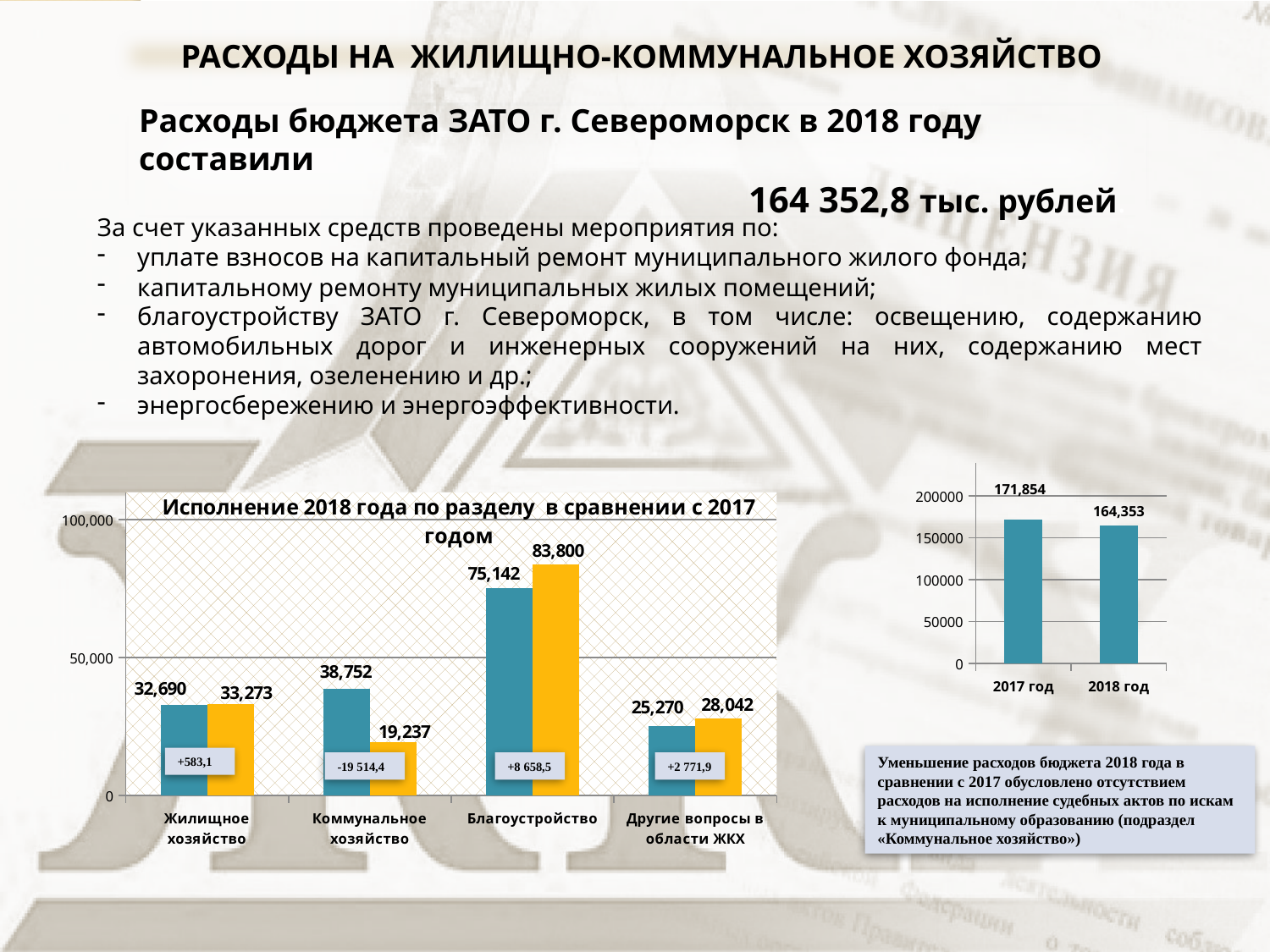
In the chart titled "Исполнение 2018 года по разделу в сравнении с 2017 годом", what is the value of the yellow (second) bar for Другие вопросы в области ЖКХ? 28,042 In the chart on the right of the slide, is the value for 2018 год greater or less than 150000? greater In the chart titled "Исполнение 2018 года по разделу в сравнении с 2017 годом", which category has the highest yellow (second) bar? Благоустройство In the chart titled "Исполнение 2018 года по разделу в сравнении с 2017 годом", how many categories are shown on the x axis? 4 In the chart titled "Исполнение 2018 года по разделу в сравнении с 2017 годом", what is the difference between the yellow and teal bars for Благоустройство? 8,658 In the chart titled "Исполнение 2018 года по разделу в сравнении с 2017 годом", what is the value of the yellow (second) bar for Коммунальное хозяйство? 19,237 In the chart titled "Исполнение 2018 года по разделу в сравнении с 2017 годом", which category has the lowest teal (first) bar? Другие вопросы в области ЖКХ In the chart titled "Исполнение 2018 года по разделу в сравнении с 2017 годом", what is the value of the teal (first) bar for Благоустройство? 75,142 In the chart on the right of the slide, what is the value for 2017 год? 171,854 What kind of chart is the chart titled "Исполнение 2018 года по разделу в сравнении с 2017 годом"? bar chart In the chart on the right of the slide, what is the difference between the values for 2017 год and 2018 год? 7,501 In the chart titled "Исполнение 2018 года по разделу в сравнении с 2017 годом", which is larger for Коммунальное хозяйство: the teal bar or the yellow bar? the teal bar (38,752)